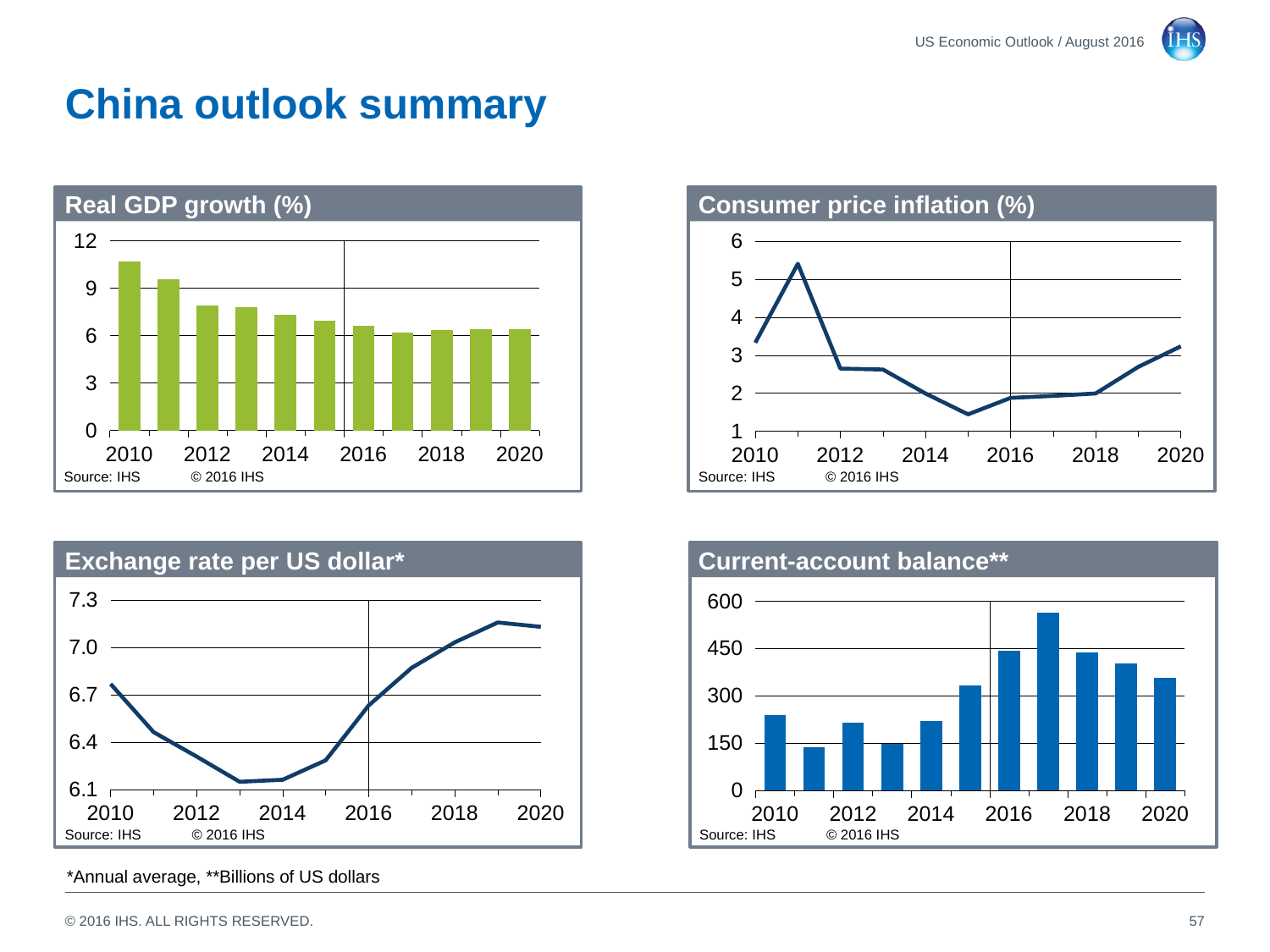
On the Real GDP growth (%) chart, is the value for 2010 greater or less than 9? greater On the Current-account balance chart, which year has the highest value? 2017 What kind of chart is the Consumer price inflation (%) chart? line chart On the Real GDP growth (%) chart, which year has the highest value? 2010 On the Consumer price inflation (%) chart, which year has the lowest value? 2015 On the Consumer price inflation (%) chart, which year has the highest value? 2011 On the Real GDP growth (%) chart, how many years are plotted? 11 On the Exchange rate per US dollar chart, which year has the lowest value? 2013 On the Real GDP growth (%) chart, do the values generally rise or fall from 2010 to 2020? fall On the Consumer price inflation (%) chart, is the value for 2011 greater or less than 5? greater On the Real GDP growth (%) chart, is the value for 2012 greater or less than 9? less